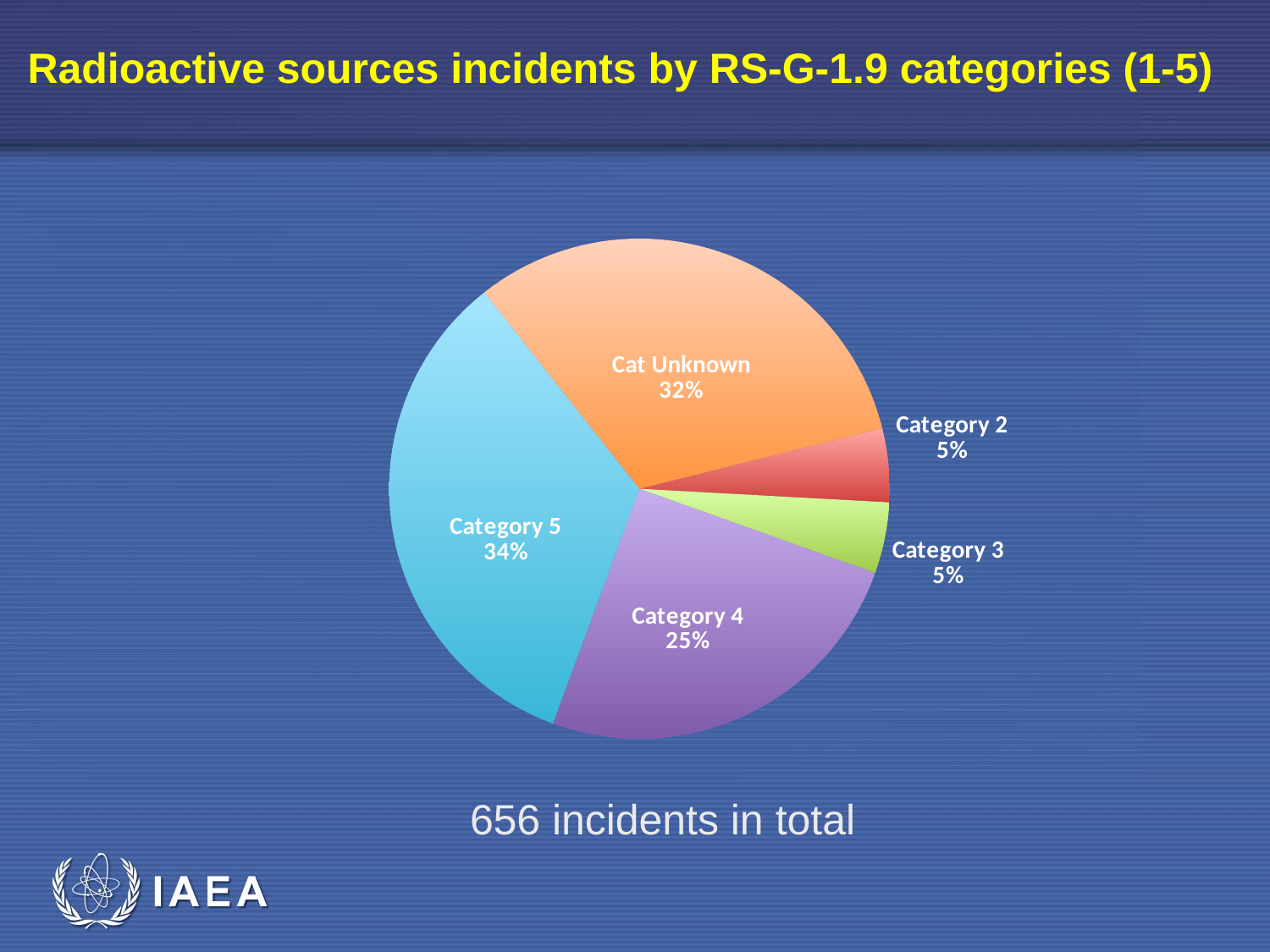
How many slices does the pie chart have? 5 What is the difference in percentage points between Cat Unknown and Category 2? 27 What share of incidents is labelled for Category 3? 5% What share of incidents is labelled for Category 4? 25% What is the difference in percentage points between Category 5 and Category 4? 9 Which is larger, the share for Category 4 or the share for Cat Unknown? Cat Unknown What is the title of the slide containing the chart? Radioactive sources incidents by RS-G-1.9 categories (1-5) What share of incidents is labelled for Category 2? 5% Which category has the largest slice of the pie? Category 5 What kind of chart is shown on the slide? Pie chart